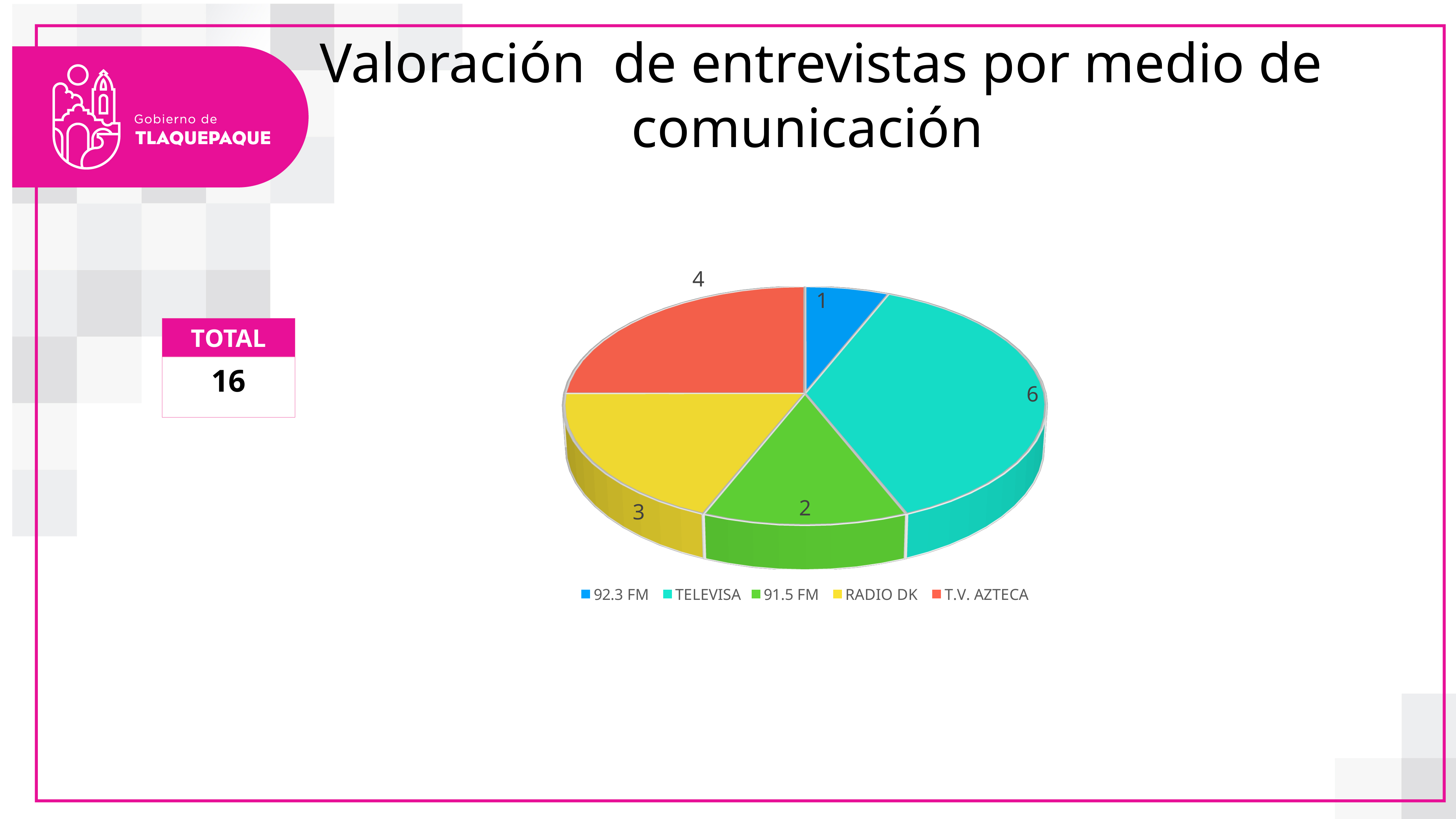
What is the value for RADIO DK? 3 How many categories does the pie chart show? 5 What share of the total does TELEVISA represent? 37.5% What is the difference between the values for TELEVISA and 91.5 FM? 4 Which medium has the largest slice of the pie? TELEVISA What kind of chart is shown on the slide? Pie chart Which is larger, the value for RADIO DK or the value for T.V. AZTECA? T.V. AZTECA What is the value for TELEVISA? 6 What is the value for 92.3 FM? 1 Which medium has the smallest slice of the pie? 92.3 FM What is the value for T.V. AZTECA? 4 What colour is the slice for 91.5 FM? Green